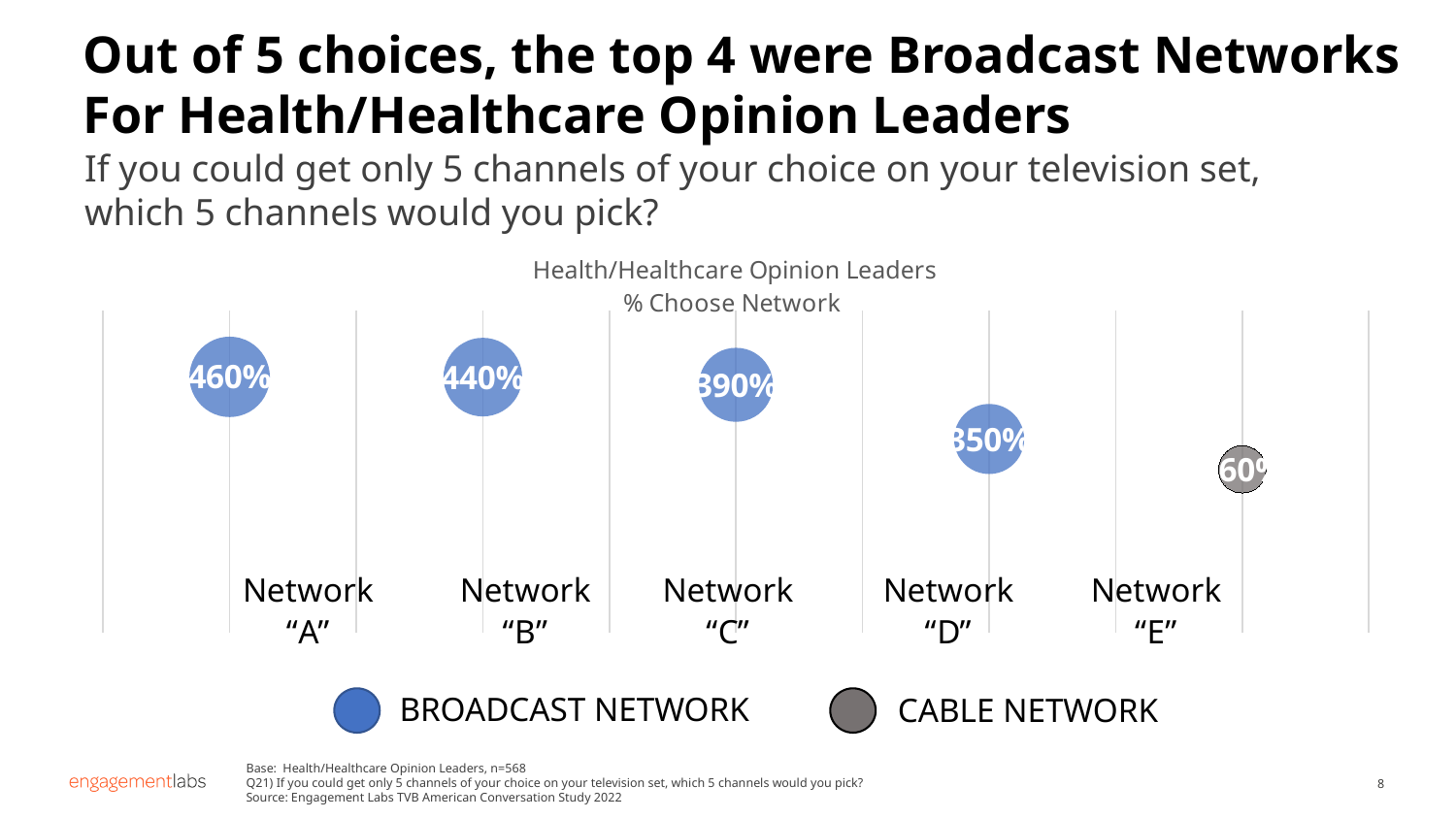
How many entries does the legend list? 2 How many networks are shown in the chart? 5 Which is larger, the value for Network "C" or Network "D"? Network "C" Which network has the lowest value? Network "E" What is the value for Network "A"? 460% What kind of chart is shown on the slide? Bubble chart What is the difference between the values for Network "A" and Network "B"? 20% Do the values rise or fall from Network "A" to Network "E"? Fall Which network has the highest value? Network "A" Which network is shown as a Cable Network in the chart? Network "E" What is the value for Network "D"? 350% What is the value for Network "B"? 440%